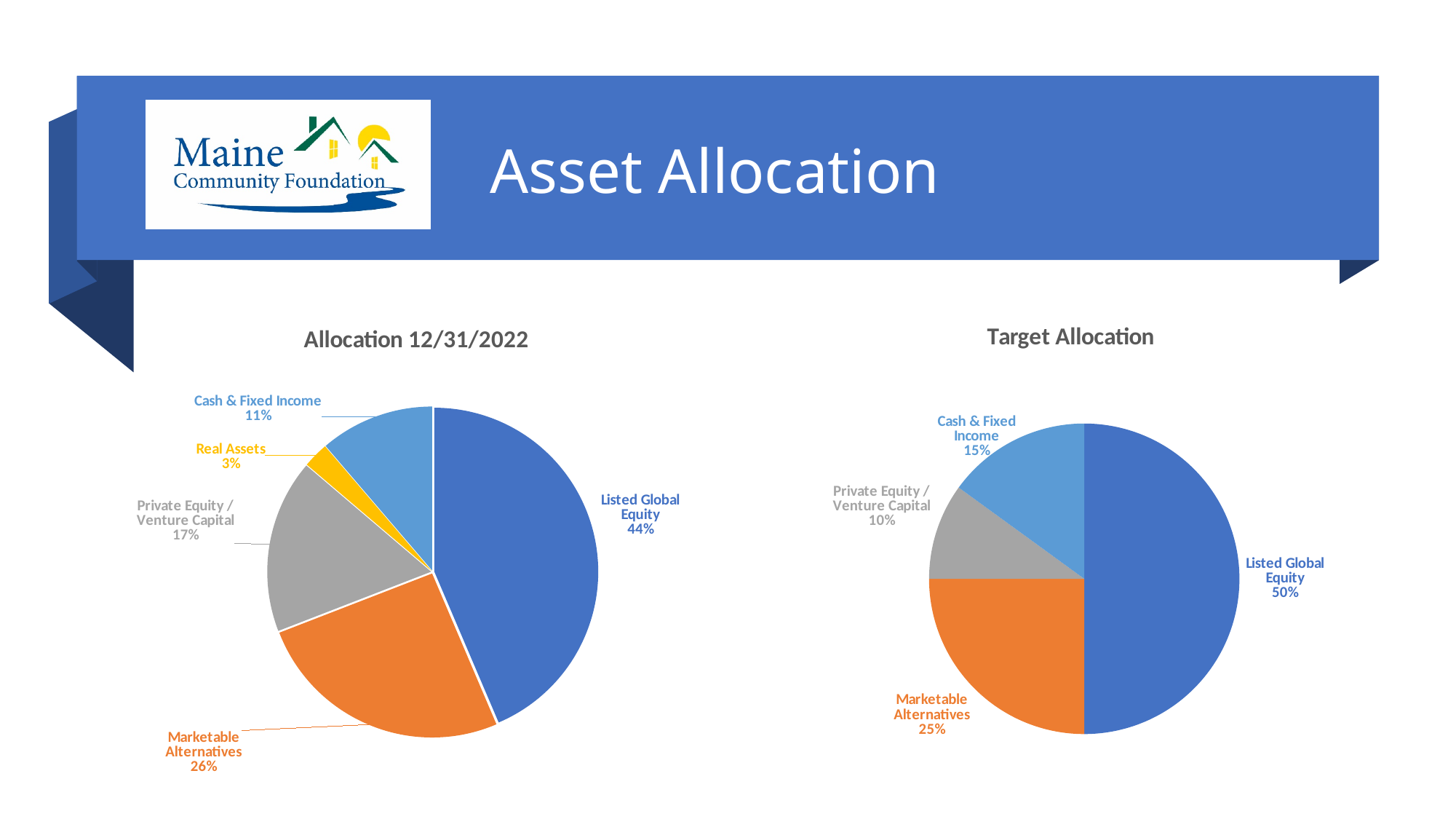
In the 'Target Allocation' chart, what is the difference between the Listed Global Equity share and the Marketable Alternatives share? 25% In the 'Allocation 12/31/2022' chart, what is the difference between the Marketable Alternatives share and the Private Equity / Venture Capital share? 9% In the 'Allocation 12/31/2022' chart, which category has the smallest share? Real Assets In the 'Target Allocation' chart, which category has the smallest share? Private Equity / Venture Capital In the 'Allocation 12/31/2022' chart, what is the share for Real Assets? 3% In the 'Target Allocation' chart, what is the share for Private Equity / Venture Capital? 10% In the 'Allocation 12/31/2022' chart, which category has the largest share? Listed Global Equity How many slices does the 'Allocation 12/31/2022' pie chart have? 5 In the 'Allocation 12/31/2022' chart, what is the share for Listed Global Equity? 44% In the 'Target Allocation' chart, what is the share for Cash & Fixed Income? 15% What type of chart is the 'Target Allocation' chart? Pie chart In the 'Allocation 12/31/2022' chart, which is larger: Cash & Fixed Income or Private Equity / Venture Capital? Private Equity / Venture Capital